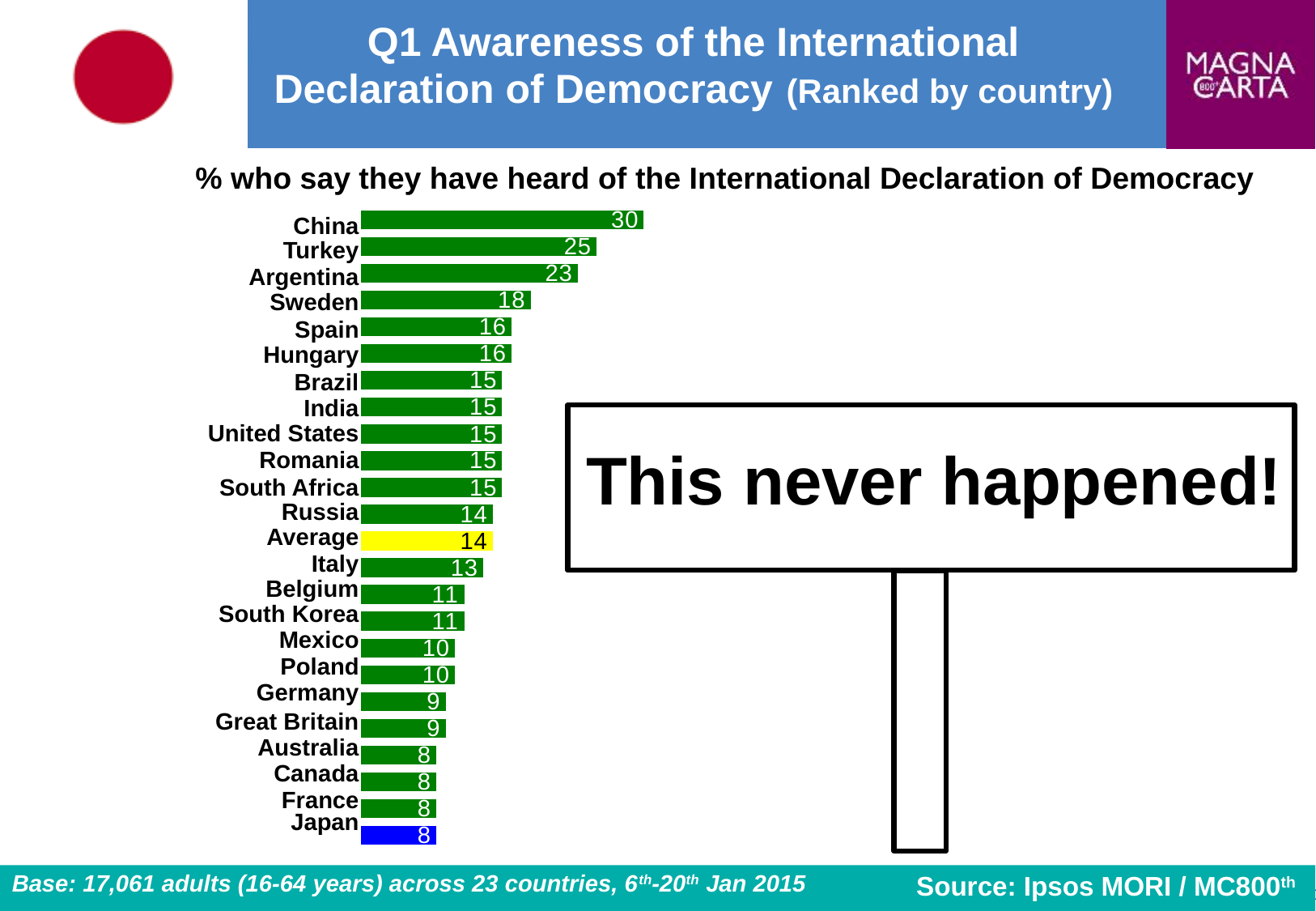
What is the value for China? 30 What is the difference between the values for China and Turkey? 5 Which country has the highest value? China What is the value for Sweden? 18 What kind of chart is shown on the slide? Bar chart Which bar is coloured yellow? Average Which has a larger value, Germany or Sweden? Sweden What is the value for the Average bar? 14 How many bars are shown in the chart, including the Average bar? 24 Which has a larger value, Russia or Belgium? Russia What is the difference between the values for Argentina and Italy? 10 What is the value for Japan? 8